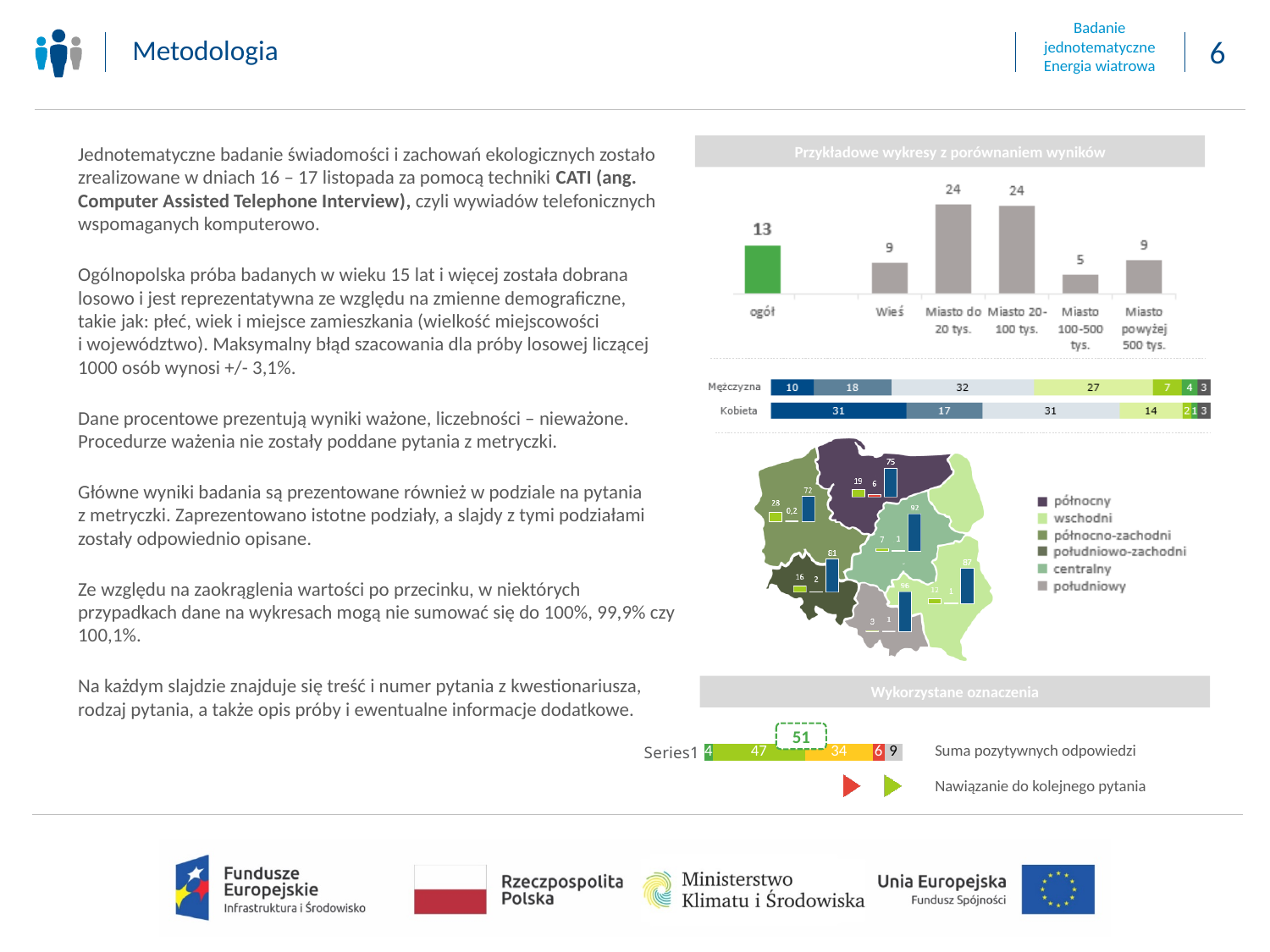
In the bar chart at the top right of the slide, how many categories are shown on the x axis? 6 In the bar chart at the top right of the slide, what is the value for 'Miasto 100-500 tys.'? 5 What kind of chart is the chart at the top right of the slide with categories 'ogół' and 'Wieś'? bar chart In the bar chart at the top right of the slide, which is larger: the value for 'ogół' or the value for 'Miasto 100-500 tys.'? ogół In the stacked bar chart at the bottom of the slide labelled 'Series1', what is the value shown in the dashed box above the bar? 51 In the stacked bar chart with rows 'Mężczyzna' and 'Kobieta', what is the difference between the first segment of 'Kobieta' and the first segment of 'Mężczyzna'? 21 In the stacked bar chart with rows 'Mężczyzna' and 'Kobieta', what is the value of the third segment for 'Mężczyzna'? 32 In the bar chart at the top right of the slide, what is the difference between the values for 'Miasto do 20 tys.' and 'Wieś'? 15 In the stacked bar chart with rows 'Mężczyzna' and 'Kobieta', what is the value of the first (leftmost) segment for 'Kobieta'? 31 In the bar chart at the top right of the slide, what is the value for 'Wieś'? 9 In the bar chart at the top right of the slide, what is the value for 'ogół'? 13 In the bar chart at the top right of the slide, which category has the lowest value? Miasto 100-500 tys.